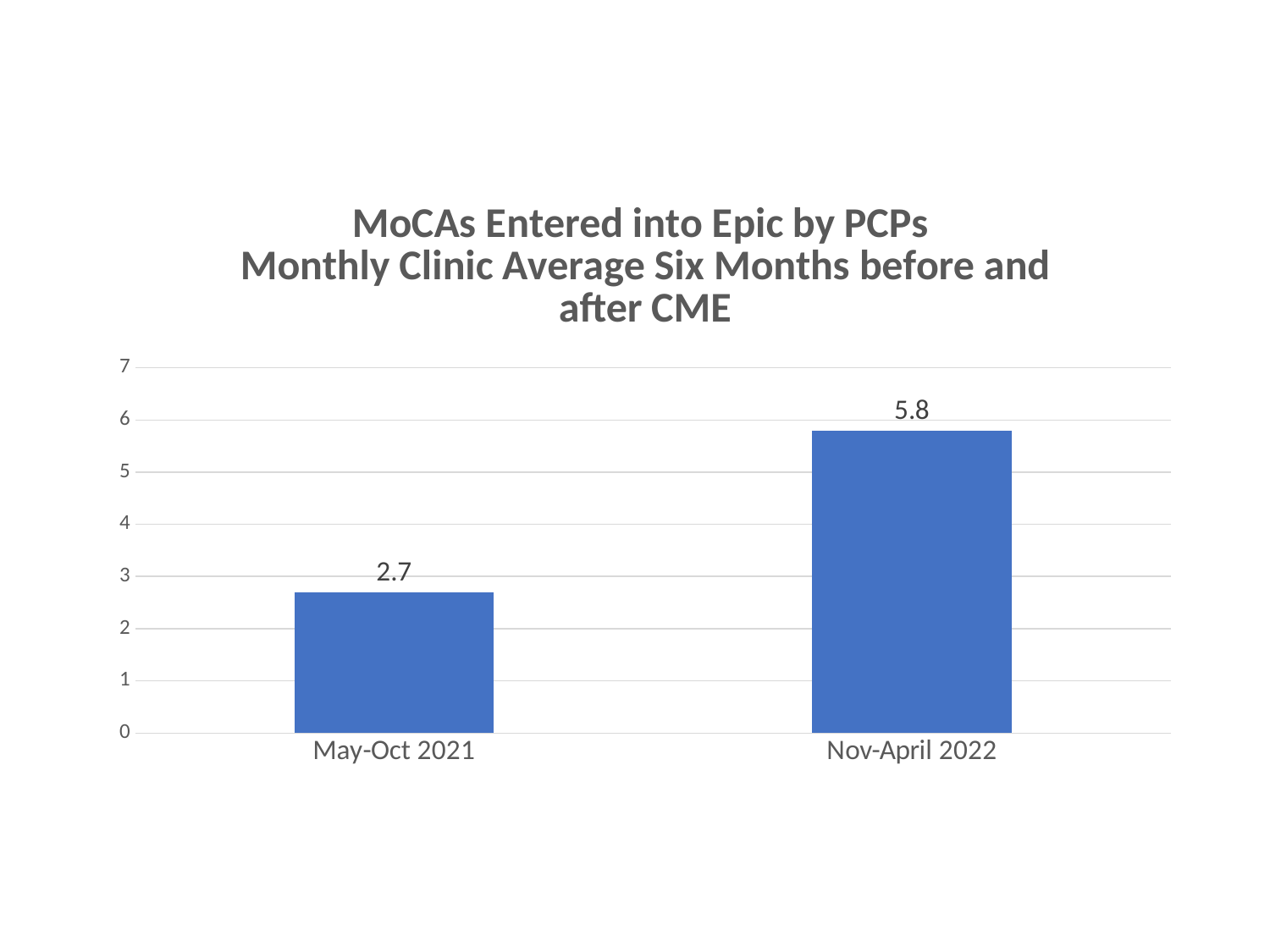
Is the value for Nov-April 2022 greater or less than 5? greater What is the first line of the chart title? MoCAs Entered into Epic by PCPs Do the values rise or fall from May-Oct 2021 to Nov-April 2022? rise What is the value for May-Oct 2021? 2.7 Which is larger, the value for May-Oct 2021 or the value for Nov-April 2022? Nov-April 2022 Which category has the highest value? Nov-April 2022 Which category has the lowest value? May-Oct 2021 How many categories are shown on the x axis? 2 Is the value for May-Oct 2021 greater or less than 3? less What is the difference between the values for Nov-April 2022 and May-Oct 2021? 3.1 What is the value for Nov-April 2022? 5.8 What kind of chart is shown on the slide? bar chart